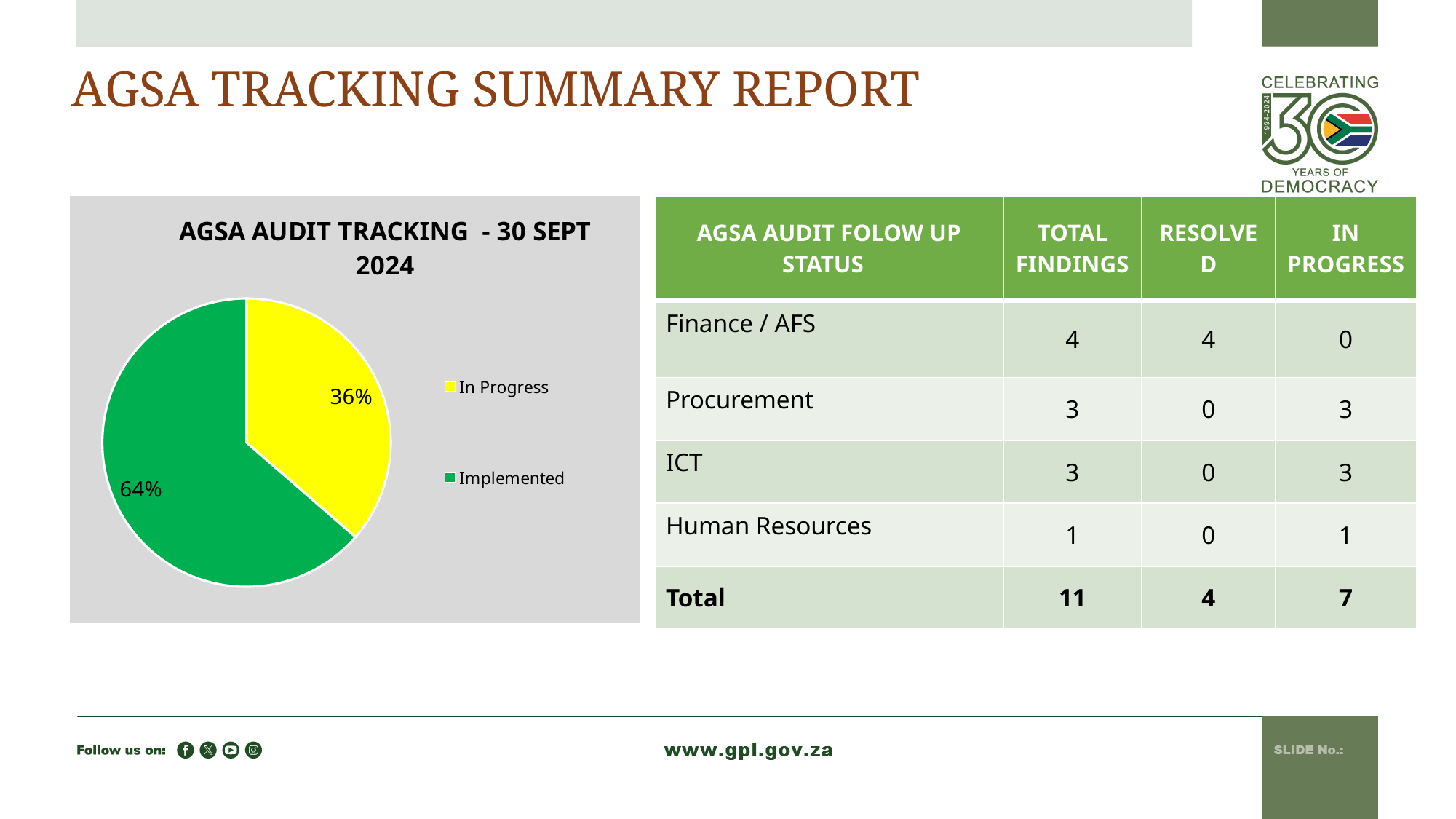
How many slices does the pie chart have? 2 What share of the pie is labelled In Progress? 36% What is the difference in percentage points between the Implemented and In Progress slices? 28 What is the title of the chart? AGSA AUDIT TRACKING - 30 SEPT 2024 What share of the pie is labelled Implemented? 64% What kind of chart is shown on the slide? Pie chart Which slice of the pie is the smallest? In Progress What colour is the In Progress slice? Yellow Which slice of the pie is the largest? Implemented How many entries does the legend list? 2 Which is larger, the In Progress slice or the Implemented slice? Implemented